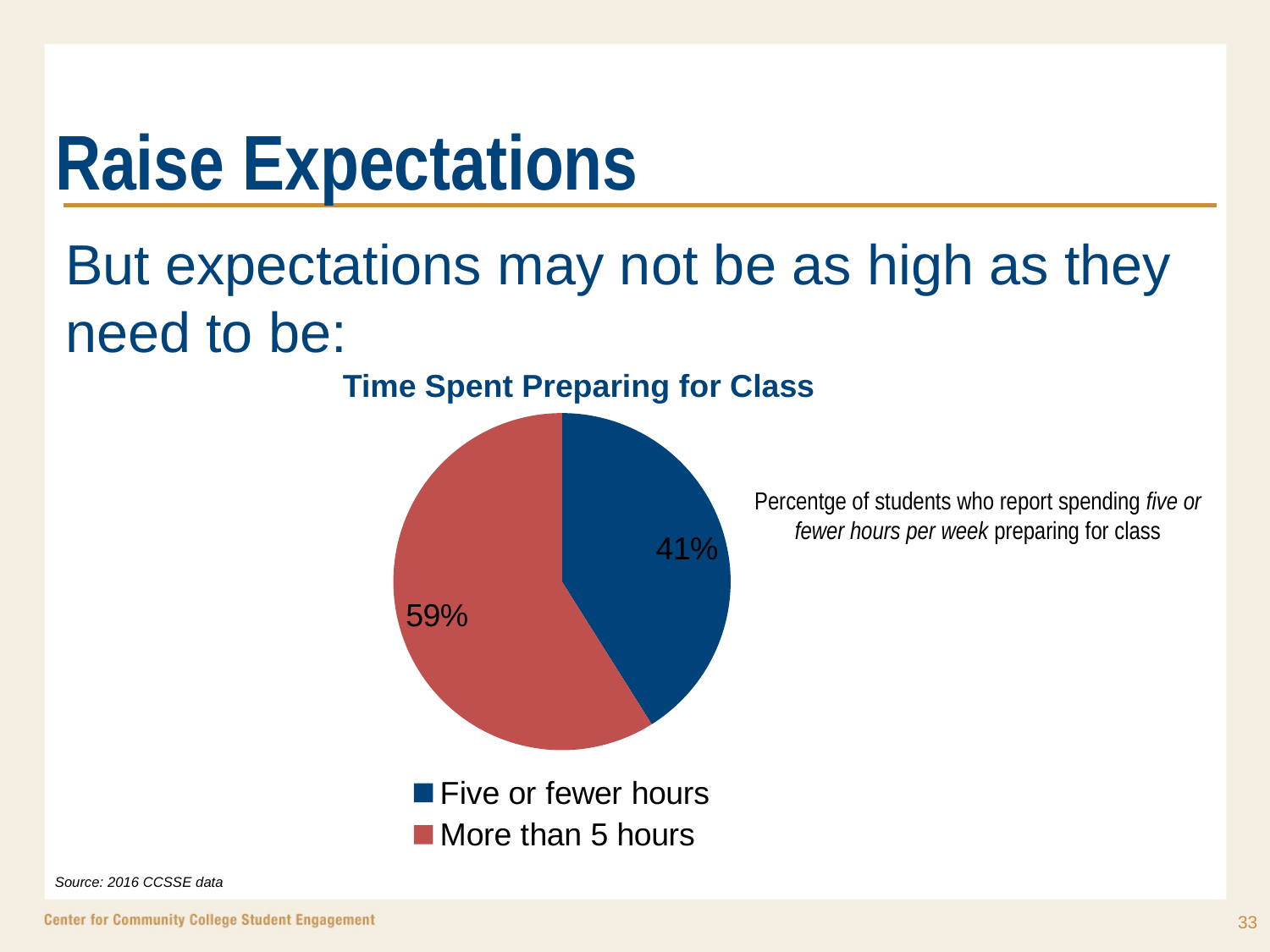
What share of the pie does the 'More than 5 hours' slice represent? 59% Which category has the largest share of the pie? More than 5 hours How many entries does the legend list? 2 What percentage of students report spending more than 5 hours preparing for class? 59% What colour is the 'Five or fewer hours' slice? Blue What kind of chart is shown on the slide? Pie chart What percentage of students report spending five or fewer hours preparing for class? 41% Which is larger: the share for 'Five or fewer hours' or the share for 'More than 5 hours'? More than 5 hours What is the title of the chart? Time Spent Preparing for Class What is the difference in percentage points between the 'More than 5 hours' and 'Five or fewer hours' slices? 18 How many slices does the pie chart have? 2 Which category has the smallest share of the pie? Five or fewer hours